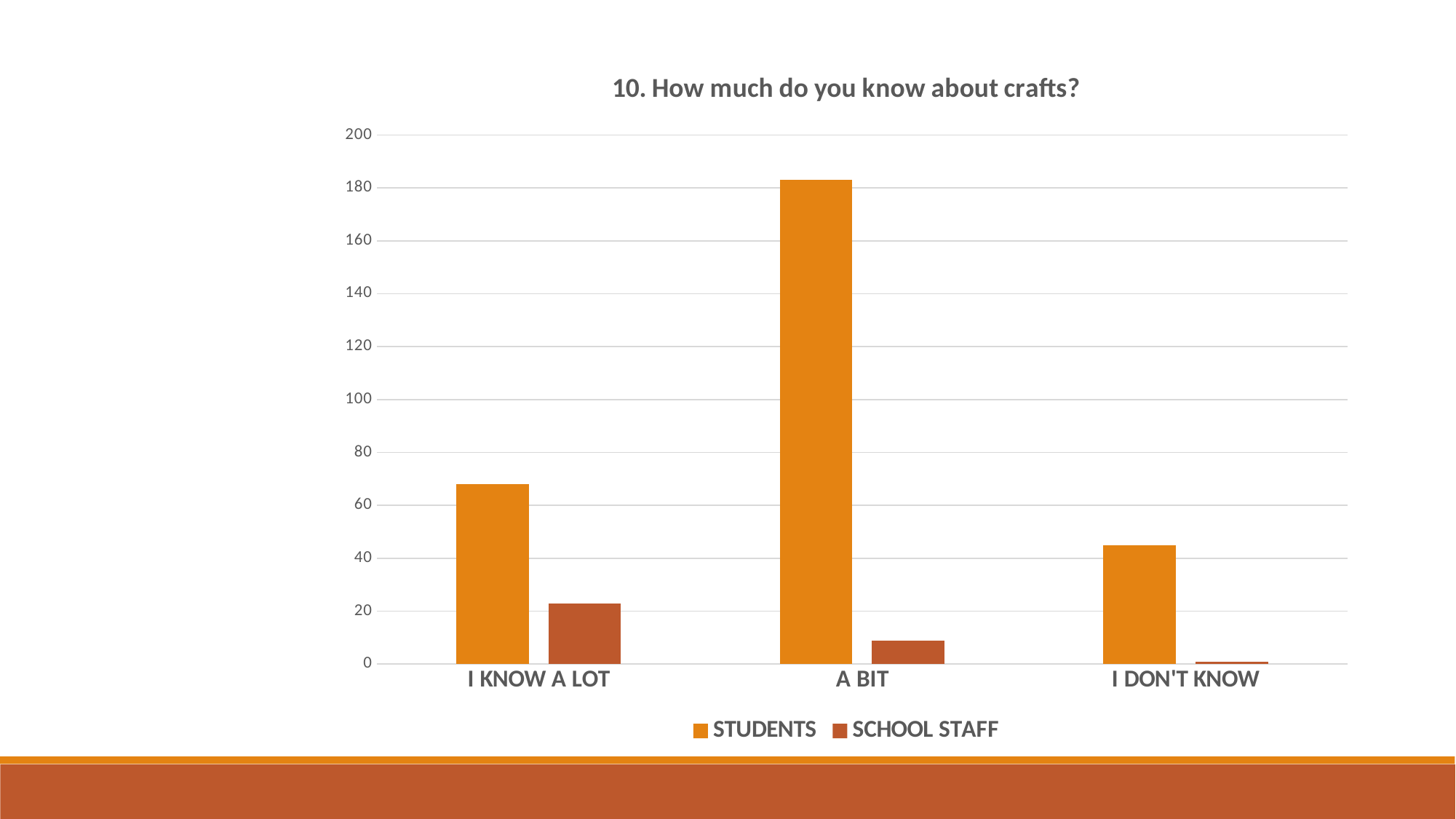
Which category has the highest value for SCHOOL STAFF? I KNOW A LOT What is the title of the chart? 10. How much do you know about crafts? How many categories are shown on the x axis? 3 How many series does the legend list? 2 Is the STUDENTS value for A BIT greater or less than 160? greater What type of chart is shown on the slide? bar chart Which category has the lowest value for SCHOOL STAFF? I DON'T KNOW Is the SCHOOL STAFF value for A BIT greater or less than 20? less For I KNOW A LOT, which series has the larger value, STUDENTS or SCHOOL STAFF? STUDENTS Is the STUDENTS value for I KNOW A LOT greater or less than 80? less Which category has the highest value for STUDENTS? A BIT Which category has the lowest value for STUDENTS? I DON'T KNOW